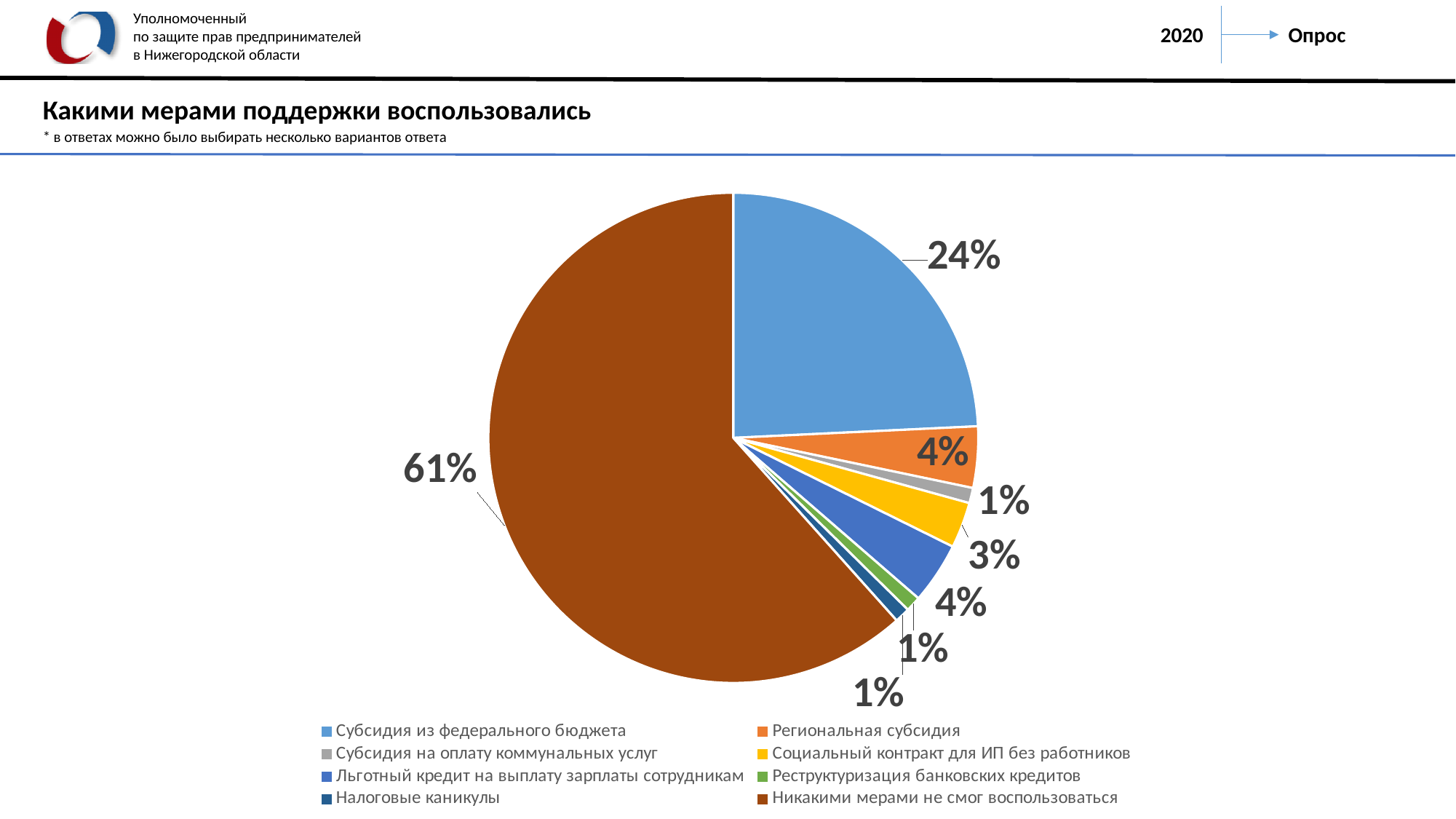
What is the difference between the share for 'Никакими мерами не смог воспользоваться' and the share for 'Субсидия из федерального бюджета'? 37% What kind of chart is shown on the slide? pie chart Which category has the largest slice of the pie? Никакими мерами не смог воспользоваться What is the value for 'Региональная субсидия'? 4% What colour is the slice for 'Социальный контракт для ИП без работников'? yellow What is the value for 'Налоговые каникулы'? 1% How many slices does the pie chart have? 8 What share of the pie is 'Субсидия из федерального бюджета'? 24% Which is larger: the share for 'Субсидия из федерального бюджета' or the share for 'Льготный кредит на выплату зарплаты сотрудникам'? Субсидия из федерального бюджета What share of the pie is 'Никакими мерами не смог воспользоваться'? 61% What is the value for 'Социальный контракт для ИП без работников'? 3% What is the title of the chart on the slide? Какими мерами поддержки воспользовались